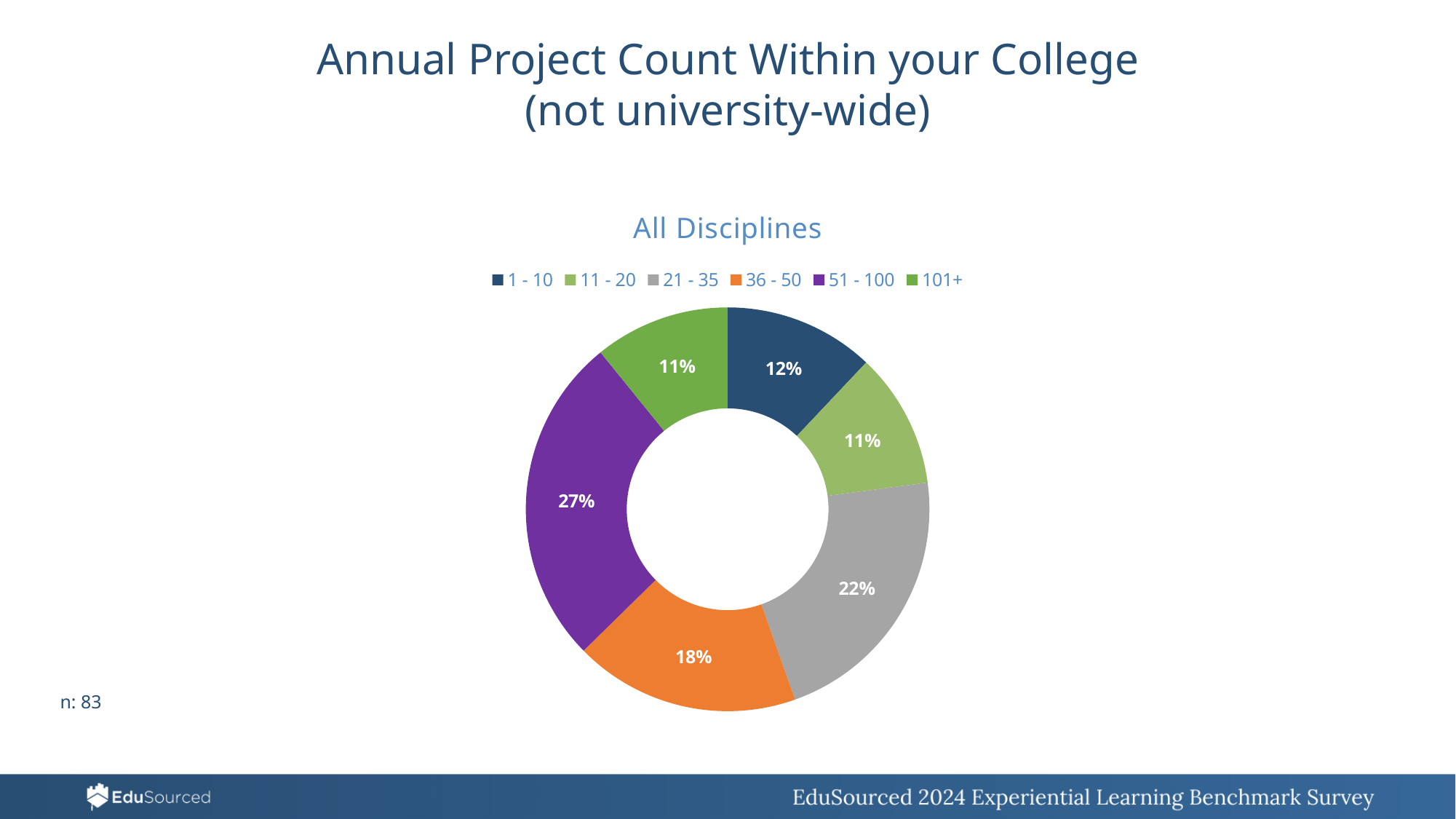
What kind of chart is shown on the slide? Pie chart (doughnut) How many categories does the legend list? 6 What is the sample size (n) shown on the slide? 83 Which project count category has the largest share of the pie? 51 - 100 What share of respondents reported 36 - 50 annual projects? 18% What share of respondents reported 1 - 10 annual projects? 12% Which slice is larger: 36 - 50 or 1 - 10? 36 - 50 What is the subtitle shown above the chart legend? All Disciplines What share of respondents reported 51 - 100 annual projects? 27% What is the combined share of the 1 - 10 and 11 - 20 slices? 23% What share of respondents reported 21 - 35 annual projects? 22% What is the difference in percentage points between the 51 - 100 slice and the 21 - 35 slice? 5